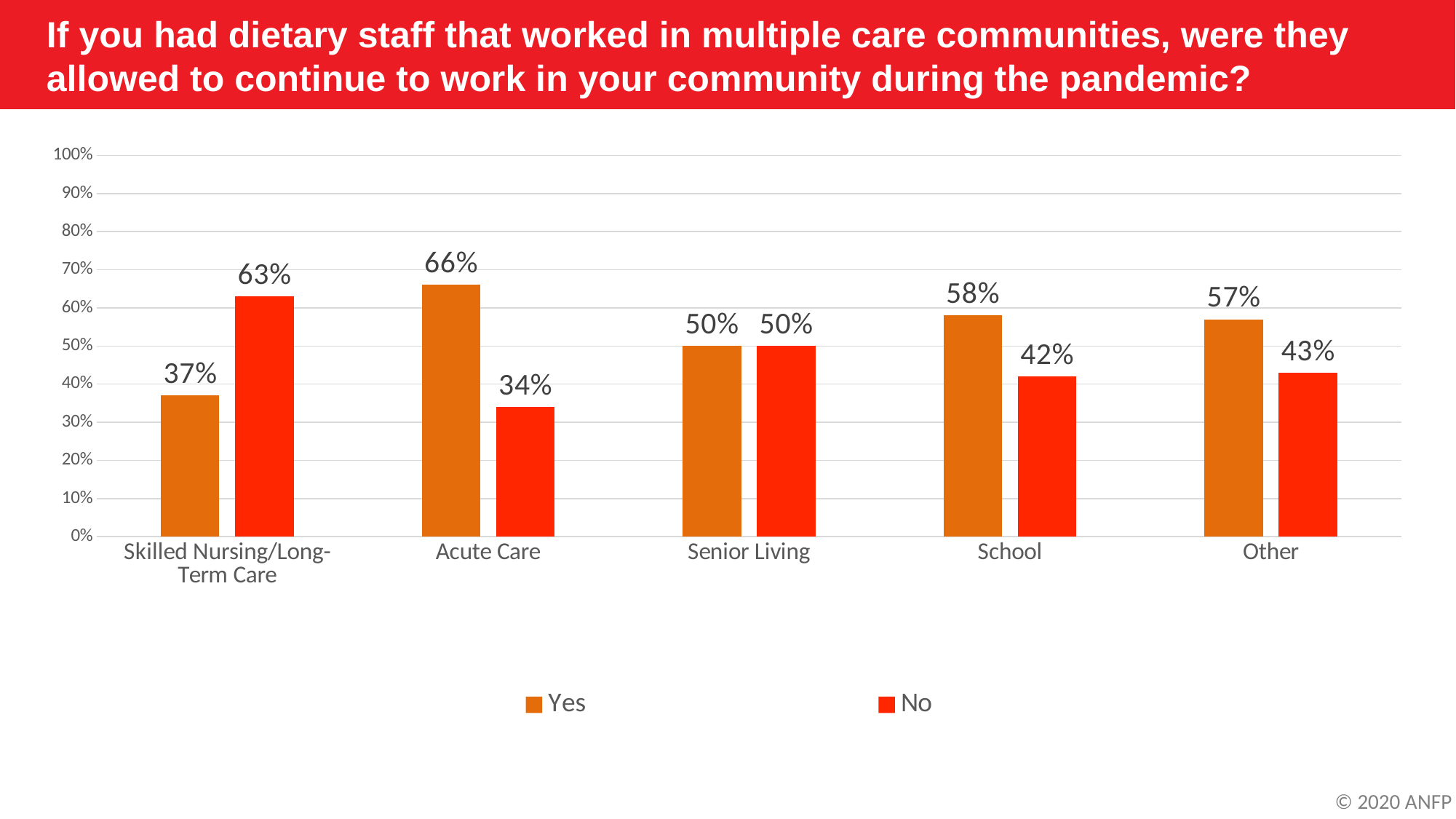
Which is larger for Skilled Nursing/Long-Term Care, the "Yes" value or the "No" value? No What is the "No" value for Skilled Nursing/Long-Term Care? 63% Which category has the lowest "No" value? Acute Care What is the "No" value for School? 42% Is the "Yes" value for School greater or less than 50%? greater What kind of chart is shown on the slide? Bar chart How many categories are shown on the x axis? 5 What colour are the "No" bars? Red How many series does the legend list? 2 What is the "Yes" value for Acute Care? 66% What is the difference between the "Yes" and "No" values for Other? 14% Which category has the highest "Yes" value? Acute Care